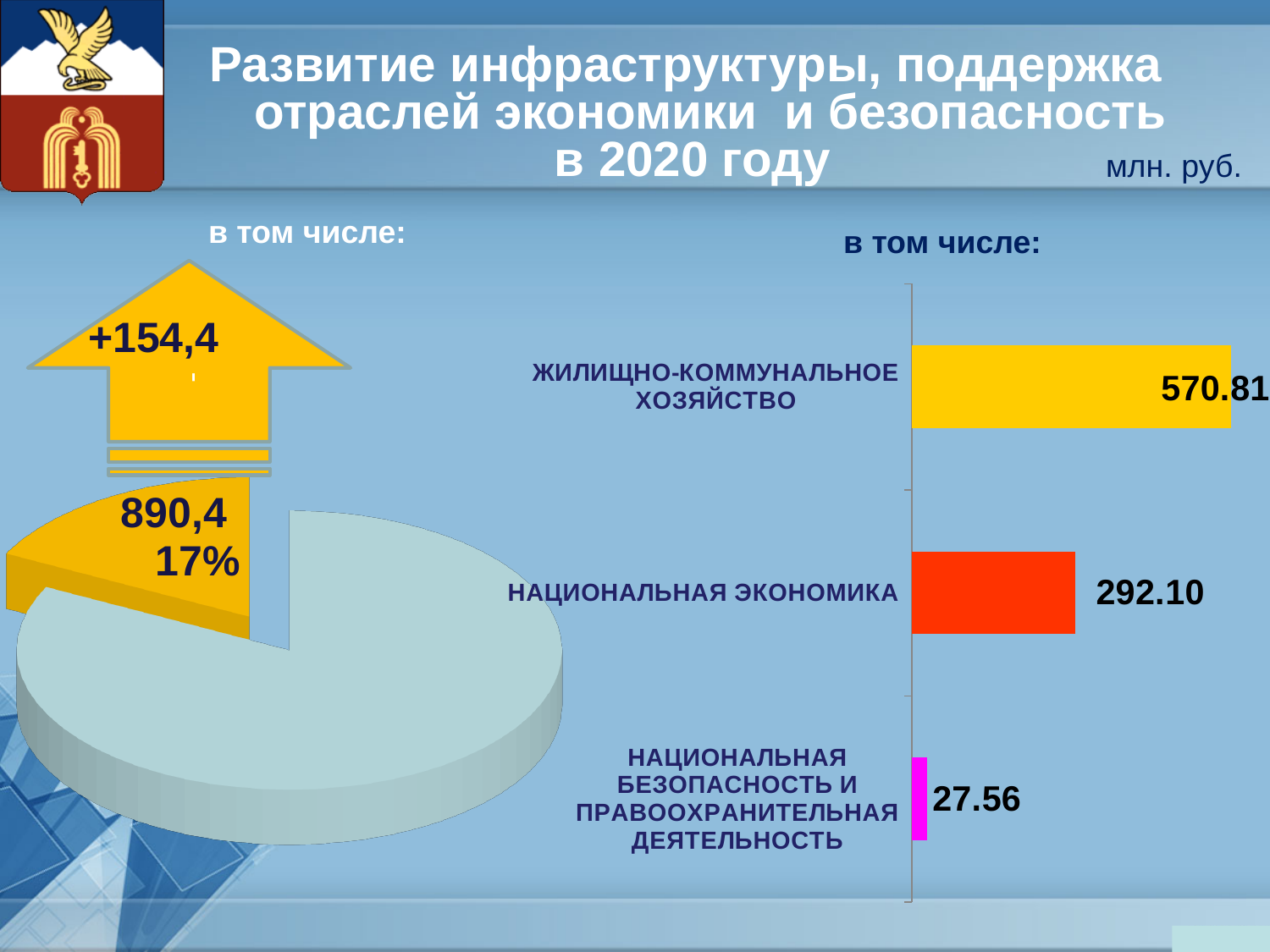
In the bar chart on the right, what is the value for ЖИЛИЩНО-КОММУНАЛЬНОЕ ХОЗЯЙСТВО? 570.81 In the bar chart on the right, which is larger: the value for НАЦИОНАЛЬНАЯ ЭКОНОМИКА or the value for НАЦИОНАЛЬНАЯ БЕЗОПАСНОСТЬ И ПРАВООХРАНИТЕЛЬНАЯ ДЕЯТЕЛЬНОСТЬ? НАЦИОНАЛЬНАЯ ЭКОНОМИКА In the bar chart on the right, what is the difference between the values for НАЦИОНАЛЬНАЯ ЭКОНОМИКА and НАЦИОНАЛЬНАЯ БЕЗОПАСНОСТЬ И ПРАВООХРАНИТЕЛЬНАЯ ДЕЯТЕЛЬНОСТЬ? 264.54 How many categories are shown in the bar chart on the right? 3 In the bar chart on the right, which category has the highest value? ЖИЛИЩНО-КОММУНАЛЬНОЕ ХОЗЯЙСТВО In the bar chart on the right, which category has the lowest value? НАЦИОНАЛЬНАЯ БЕЗОПАСНОСТЬ И ПРАВООХРАНИТЕЛЬНАЯ ДЕЯТЕЛЬНОСТЬ In the pie chart on the left, what share of the pie does the highlighted yellow slice represent? 17% In the bar chart on the right, what is the difference between the values for ЖИЛИЩНО-КОММУНАЛЬНОЕ ХОЗЯЙСТВО and НАЦИОНАЛЬНАЯ ЭКОНОМИКА? 278.71 In the bar chart on the right, what is the value for НАЦИОНАЛЬНАЯ БЕЗОПАСНОСТЬ И ПРАВООХРАНИТЕЛЬНАЯ ДЕЯТЕЛЬНОСТЬ? 27.56 What kind of chart is shown on the right side of the slide? Bar chart What kind of chart is shown on the left side of the slide? Pie chart In the bar chart on the right, what is the value for НАЦИОНАЛЬНАЯ ЭКОНОМИКА? 292.10